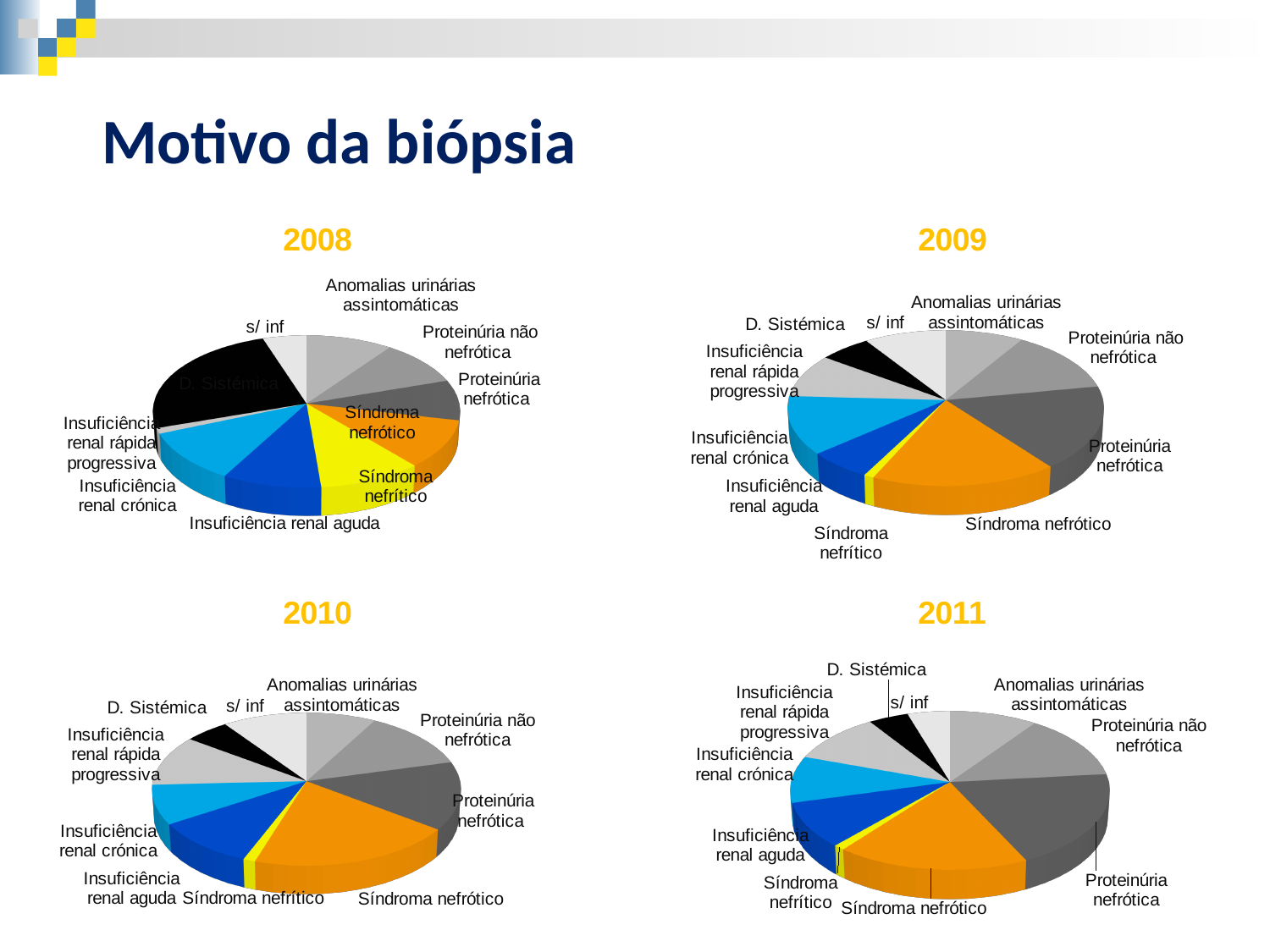
How many categories (slices) does the 2011 pie chart have? 10 In the 2011 chart, which slice is larger: Proteinúria nefrótica or s/ inf? Proteinúria nefrótica In the 2011 chart, which category has the largest slice? Proteinúria nefrótica In the 2010 chart, which category has the smallest slice? Síndroma nefrítico What is the title of the slide containing the four pie charts? Motivo da biópsia What kind of chart is the 2008 chart? Pie chart How many categories (slices) does the 2009 pie chart have? 10 In the 2009 chart, which slice is larger: Síndroma nefrótico or Insuficiência renal aguda? Síndroma nefrótico In the 2011 chart, which category has the smallest slice? Síndroma nefrítico How many pie charts are shown on the slide? 4 In the 2010 chart, which category has the largest slice? Síndroma nefrótico